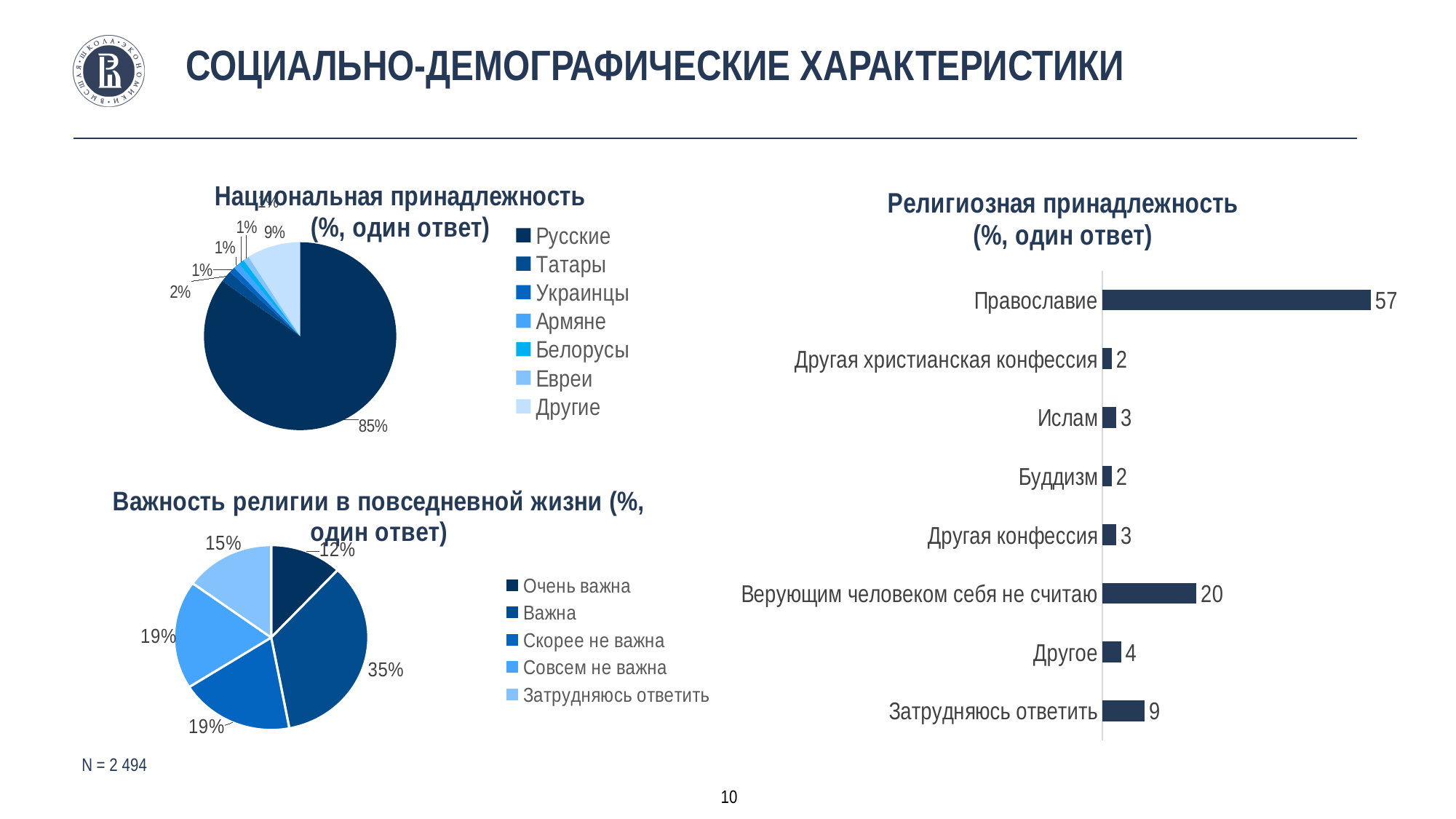
How many entries does the legend of the 'Важность религии в повседневной жизни' pie chart list? 5 In the 'Религиозная принадлежность' bar chart, what is the difference between Православие and 'Верующим человеком себя не считаю'? 37 In the 'Религиозная принадлежность' bar chart, how many categories are shown? 8 In the 'Религиозная принадлежность' bar chart, which category has the highest value? Православие In the 'Религиозная принадлежность' bar chart, what is the value for 'Верующим человеком себя не считаю'? 20 In the 'Религиозная принадлежность' bar chart, what is the value for Православие? 57 In the 'Национальная принадлежность' pie chart, what is the value for Другие? 9% In the 'Религиозная принадлежность' bar chart, which is larger: Ислам or Другое? Другое What kind of chart is 'Религиозная принадлежность'? Bar chart In the 'Важность религии в повседневной жизни' pie chart, which category has the smallest share? Очень важна In the 'Важность религии в повседневной жизни' pie chart, what is the value for Важна? 35% In the 'Национальная принадлежность' pie chart, what share do Русские have? 85%